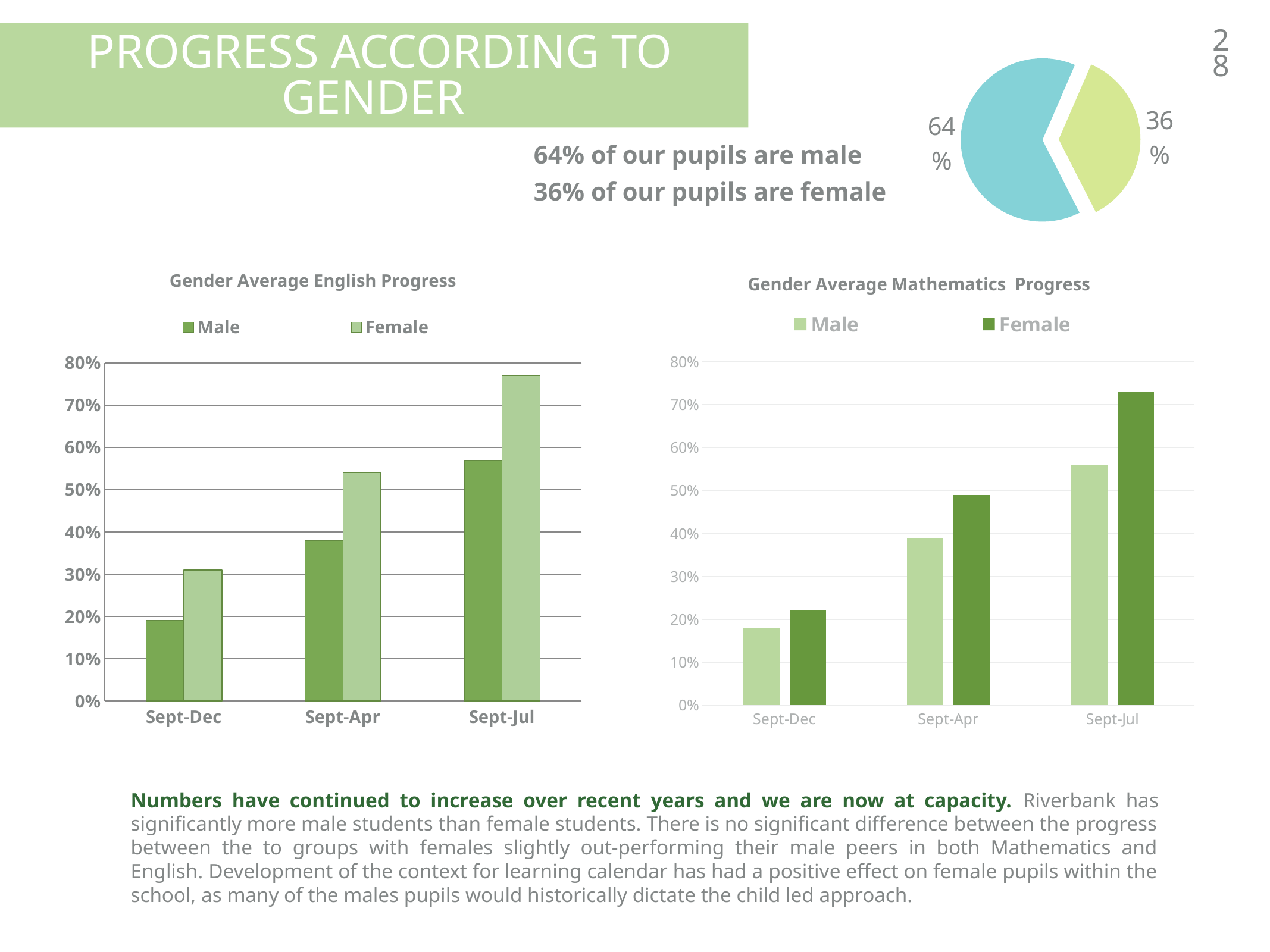
In the Gender Average English Progress chart, is the Female value for Sept-Jul greater or less than 70%? greater In the pie chart at the top right, what percentage of pupils are male? 64% In the pie chart at the top right, what is the difference between the male and female shares? 28% What kind of chart is the Gender Average Mathematics Progress chart? Bar chart In the Gender Average English Progress chart, which is larger for Sept-Apr, Male or Female? Female In the Gender Average English Progress chart, do the Male values rise or fall from Sept-Dec to Sept-Jul? rise In the Gender Average English Progress chart, how many series does the legend list? 2 In the Gender Average Mathematics Progress chart, which bar is the highest? Female, Sept-Jul In the Gender Average English Progress chart, how many categories are shown on the x axis? 3 In the pie chart at the top right, which group has the larger share of pupils? Male